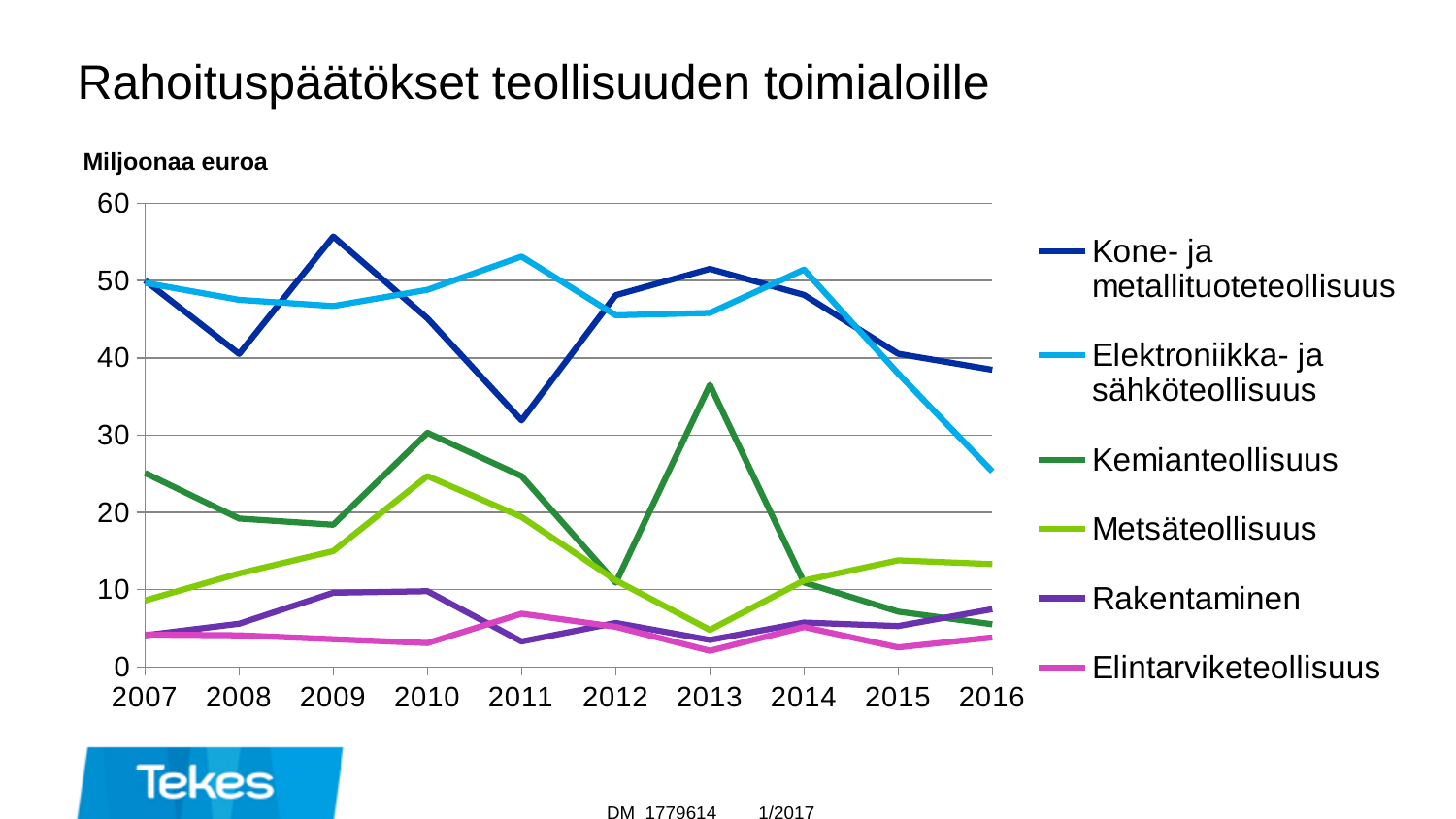
Does the value for Elektroniikka- ja sähköteollisuus rise or fall from 2014 to 2016? fall Which series has the highest value in 2013? Kone- ja metallituoteteollisuus Is the value for Metsäteollisuus in 2010 greater or less than 20? greater Is the value for Kone- ja metallituoteteollisuus in 2009 greater or less than 50? greater What kind of chart is shown on the slide? line chart Is the value for Kemianteollisuus in 2013 greater or less than 30? greater In which year does Kemianteollisuus reach its highest value? 2013 How many years are shown on the x axis? 10 In 2011, which is larger: Kone- ja metallituoteteollisuus or Elektroniikka- ja sähköteollisuus? Elektroniikka- ja sähköteollisuus How many series does the legend list? 6 Which series has the lowest value in 2010? Elintarviketeollisuus